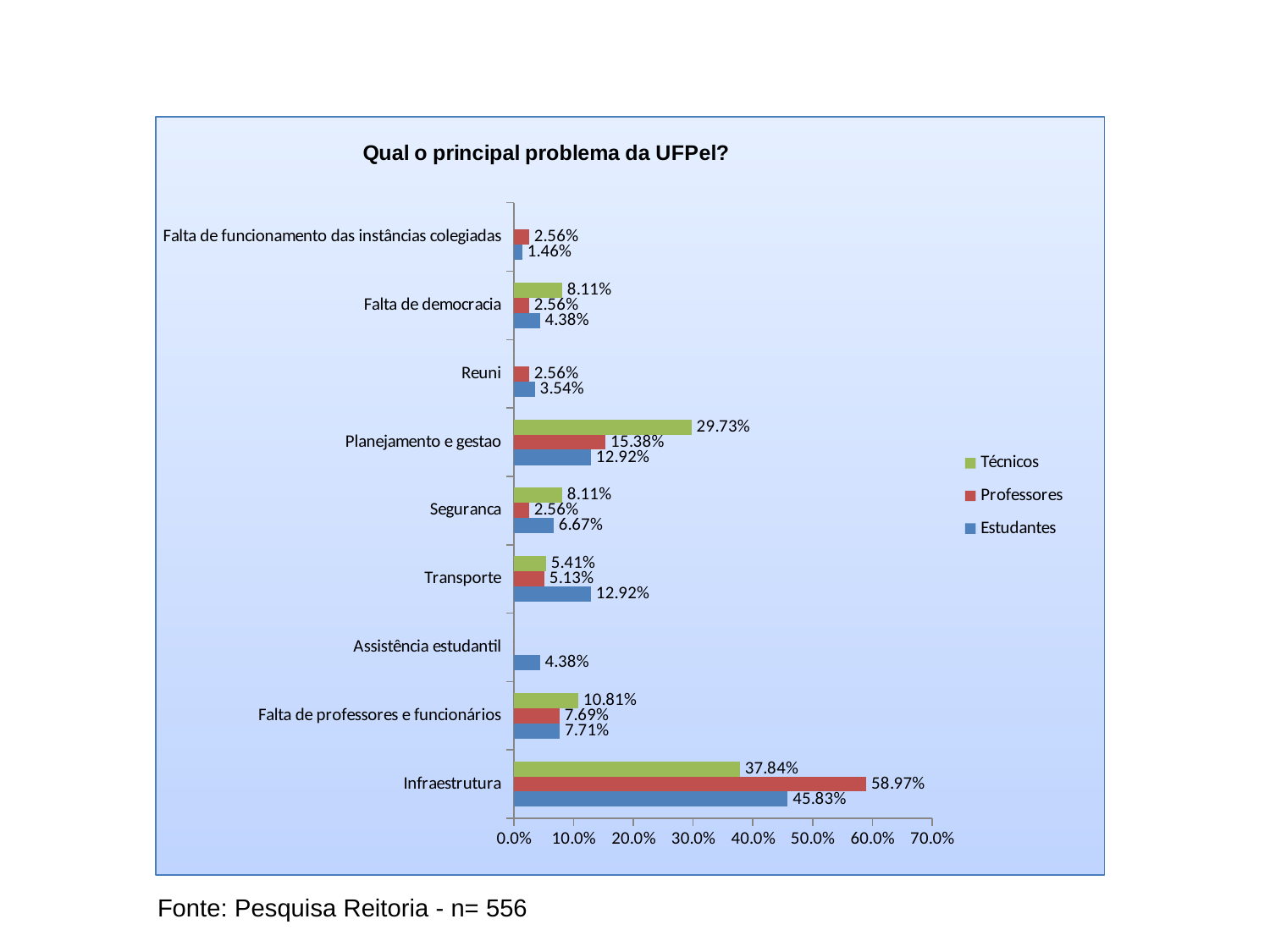
What is the value for Professores in the Infraestrutura category? 58.97% Is the value for Técnicos in Infraestrutura greater or less than 40.0%? less How many series does the legend list? 3 What is the value for Estudantes in the Transporte category? 12.92% What is the difference between the Professores and Estudantes values for Infraestrutura? 13.14% Which category has the highest value for Estudantes? Infraestrutura What kind of chart is shown on the slide? bar chart What is the title of the chart? Qual o principal problema da UFPel? How many categories are shown on the chart? 9 Which is larger for Planejamento e gestao: the Técnicos value or the Professores value? Técnicos What is the value for Técnicos in the Planejamento e gestao category? 29.73% Which category has the lowest value for Estudantes? Falta de funcionamento das instâncias colegiadas